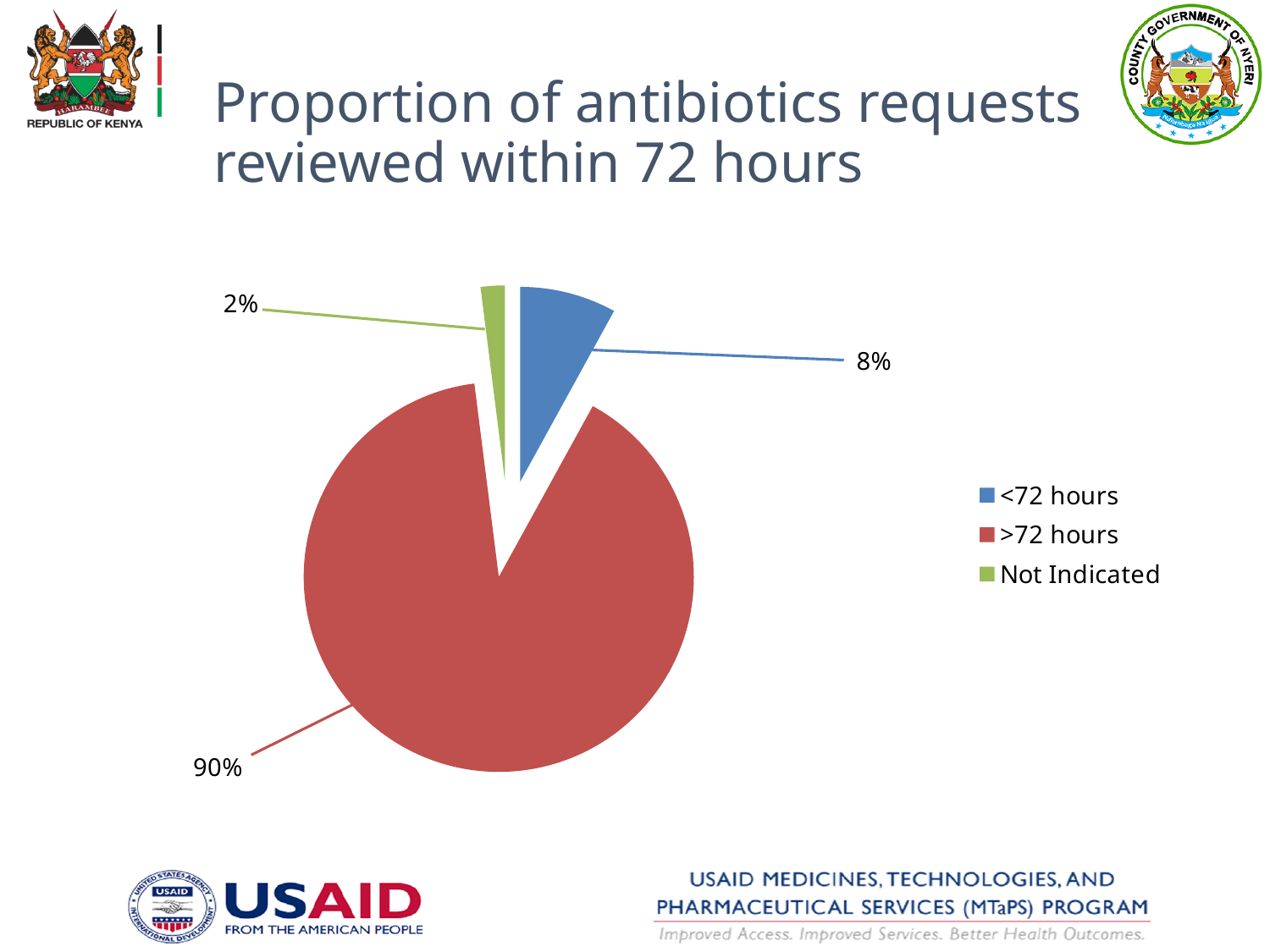
What is the title of the slide containing the chart? Proportion of antibiotics requests reviewed within 72 hours What percentage of antibiotics requests are labelled Not Indicated? 2% What percentage of antibiotics requests were reviewed in <72 hours? 8% How many slices does the pie chart have? 3 Which category has the largest share of the pie? >72 hours What is the difference in percentage points between the >72 hours and <72 hours slices? 82 How many entries does the legend list? 3 What percentage of antibiotics requests were reviewed in >72 hours? 90% Which category has the smallest share of the pie? Not Indicated What type of chart is shown on the slide? pie chart Which is larger, the <72 hours slice or the Not Indicated slice? <72 hours What colour is the >72 hours slice? red